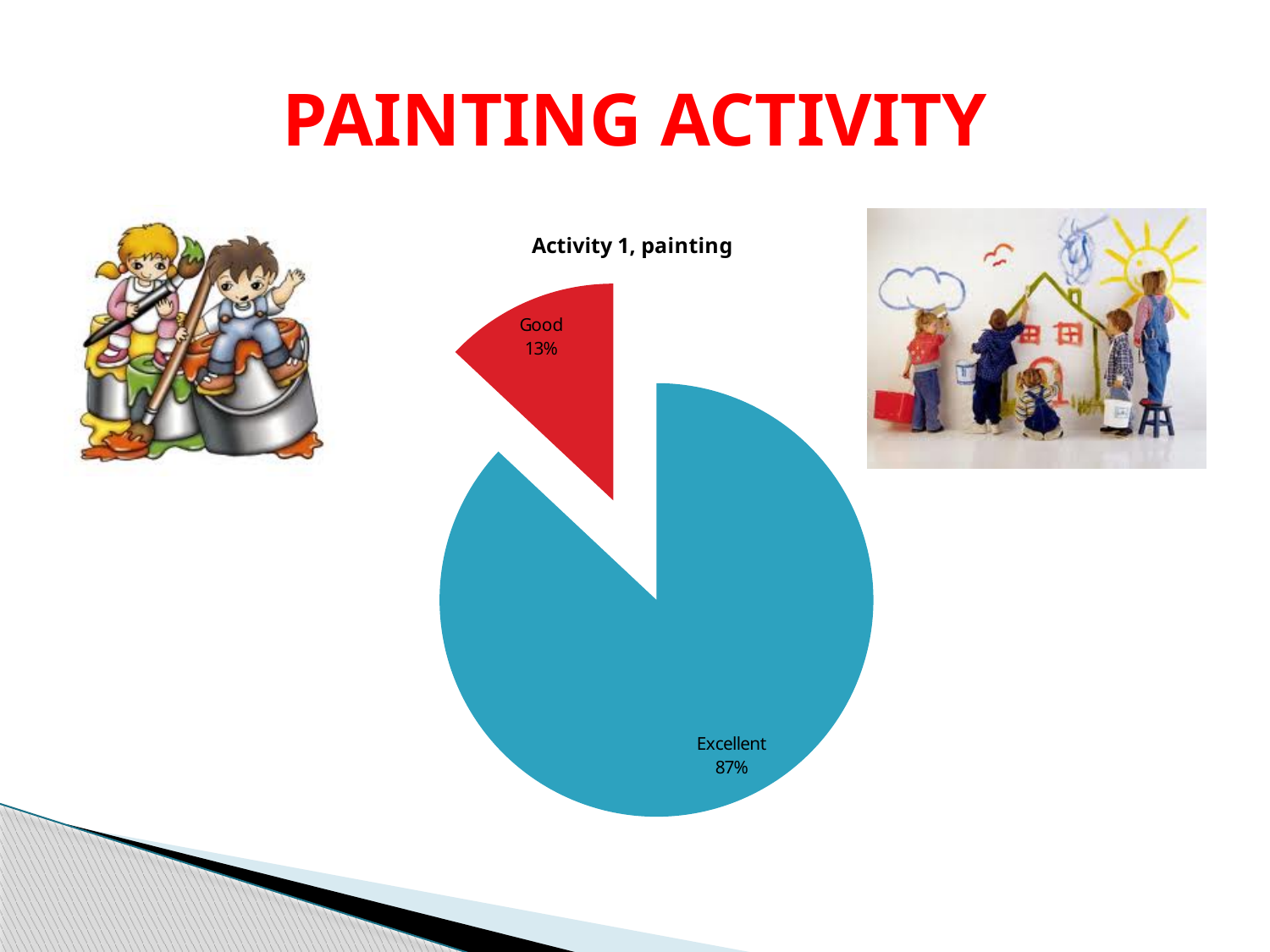
Which category has the largest share of the pie? Excellent What colour is the Good slice? red What percentage of the pie is labelled Excellent? 87% How many slices does the pie chart have? 2 What percentage of the pie is labelled Good? 13% Which slice is larger, Good or Excellent? Excellent What share of the pie does the Excellent slice represent? 87% Which category has the smallest share of the pie? Good What is the title of the chart? Activity 1, painting What is the difference in percentage points between the Excellent and Good slices? 74 What type of chart is shown on the slide? pie chart